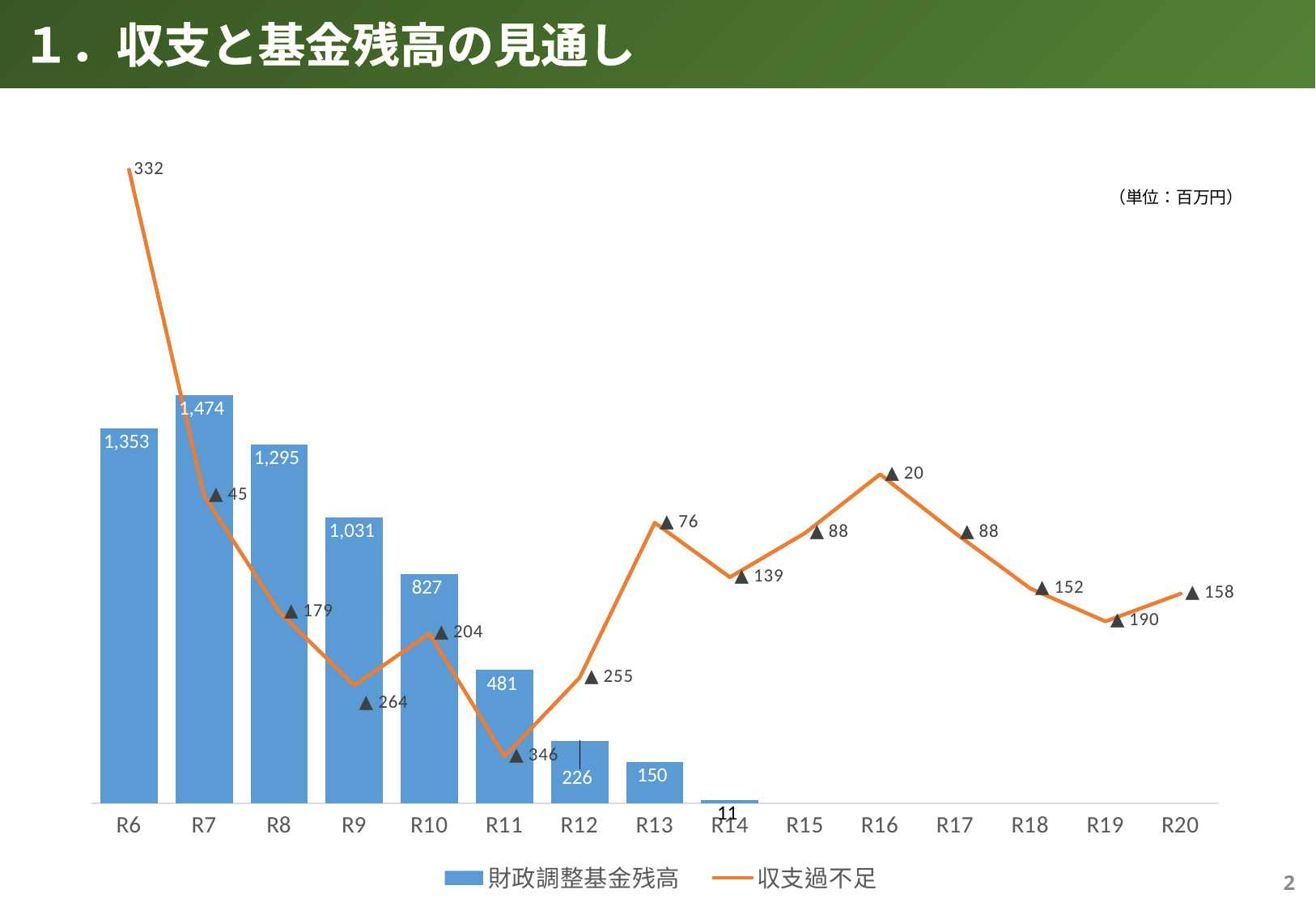
What is the value of 収支過不足 for R11? ▲346 How many years (categories) are shown on the x axis? 15 What is the value of 収支過不足 for R16? ▲20 Which is larger, the 財政調整基金残高 for R9 or for R10? R9 What is the difference between the 財政調整基金残高 values for R7 and R6? 121 Which year has the lowest 財政調整基金残高 among the bars shown? R14 What kind of chart is shown on the slide? Combined bar and line chart Which year has the highest 財政調整基金残高? R7 What is the value of 財政調整基金残高 for R6? 1,353 Do the 財政調整基金残高 bars rise or fall from R7 to R14? Fall How many series does the legend list? 2 What is the value of 財政調整基金残高 for R12? 226